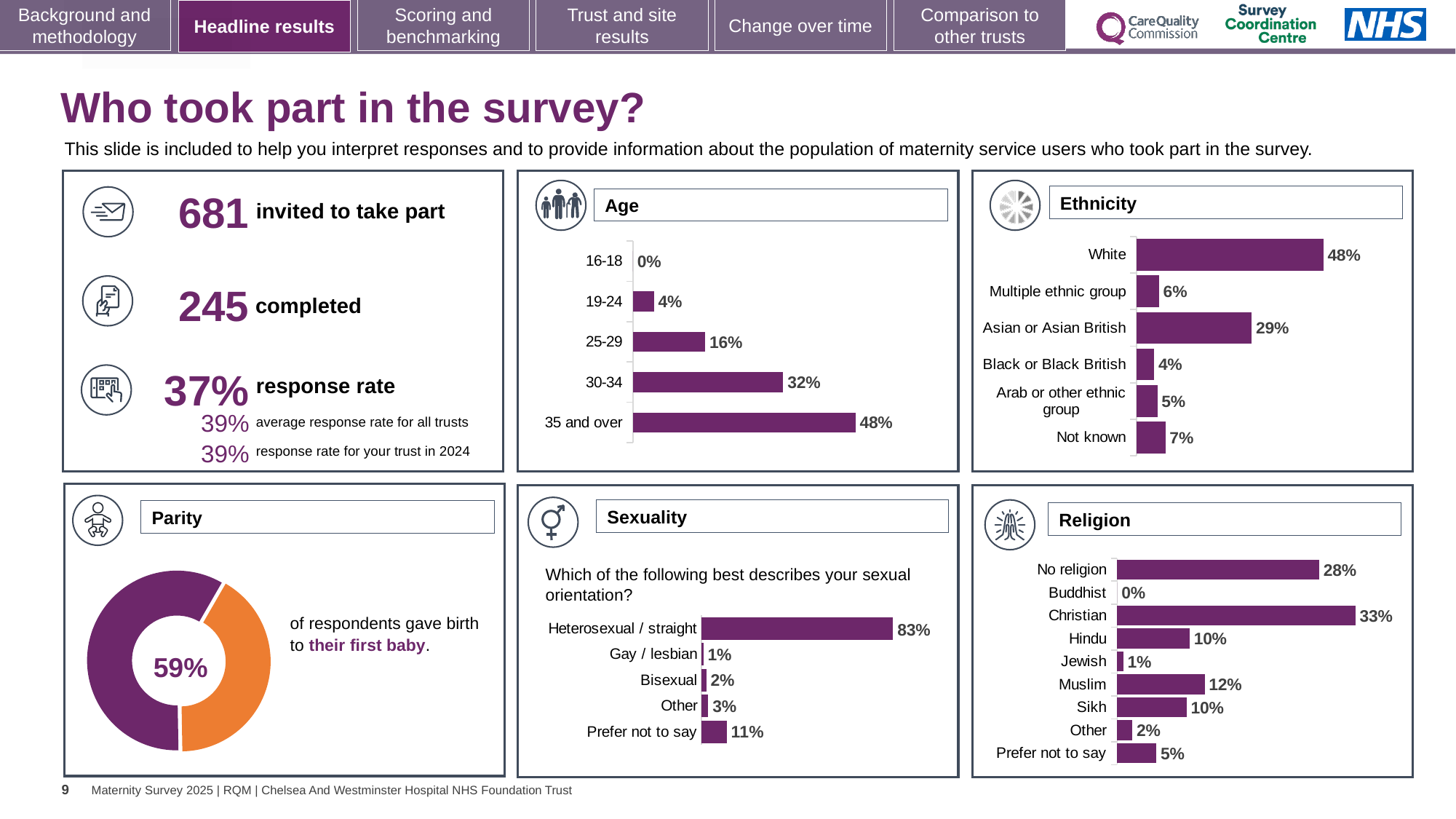
In the Age chart, what is the difference between the 30-34 and 25-29 values? 16% In the Sexuality chart, which is larger, Bisexual or Other? Other In the Religion chart, which category has the highest value? Christian What kind of chart is the Parity chart? doughnut chart In the Sexuality chart, what is the value for Prefer not to say? 11% In the Age chart, what percentage of respondents were aged 35 and over? 48% In the Religion chart, what is the difference between Christian and No religion? 5% In the Ethnicity chart, which category has the highest value? White In the Age chart, do the values rise or fall as you go from 16-18 to 35 and over? rise How many categories are shown in the Ethnicity chart? 6 In the Age chart, which age group has the lowest value? 16-18 In the Ethnicity chart, what is the value for Asian or Asian British? 29%